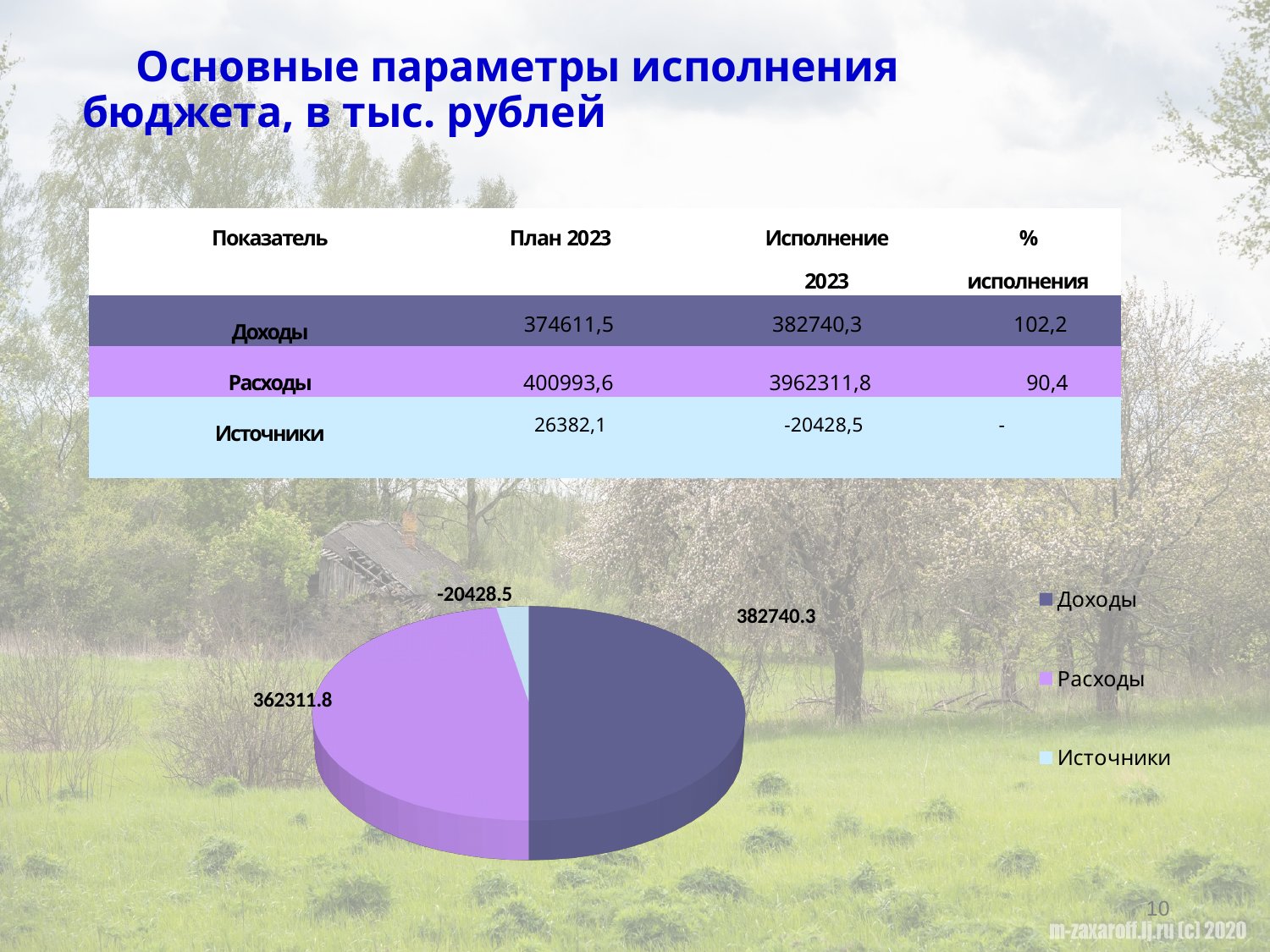
What are the legend entries of the pie chart? Доходы, Расходы, Источники What is the difference between the values for Доходы and Расходы on the pie chart? 20428.5 What value is shown for Расходы on the pie chart? 362311.8 What value is shown for Источники on the pie chart? -20428.5 What value is shown for Доходы on the pie chart? 382740.3 How many entries does the pie chart legend list? 3 Which is larger on the pie chart, Доходы or Расходы? Доходы What kind of chart is shown on the slide? pie chart How many slices does the pie chart have? 3 Which category has the largest slice in the pie chart? Доходы What colour is the Источники slice in the pie chart? light blue Which category has the smallest slice in the pie chart? Источники